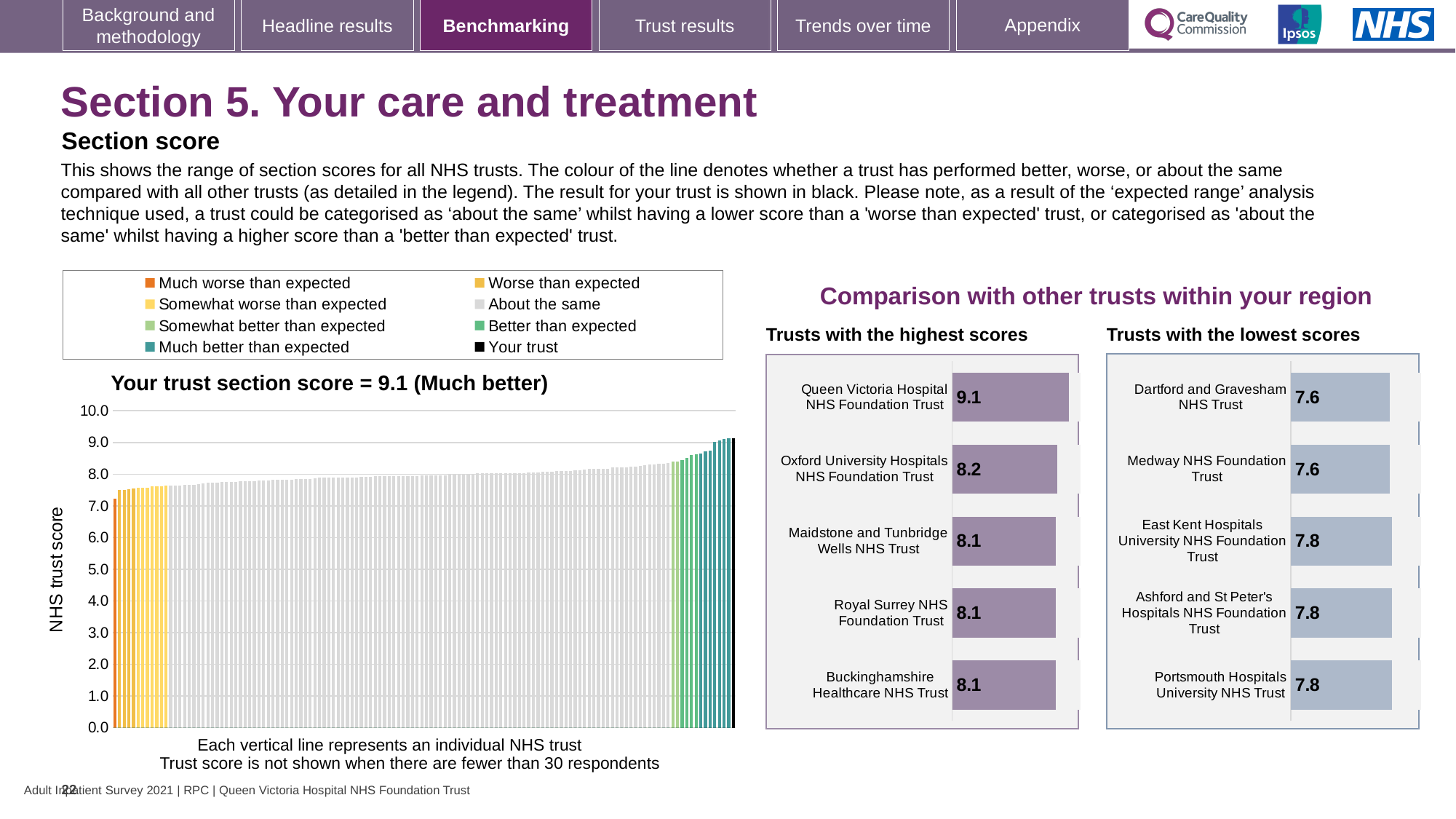
How many entries does the legend above the 'Your trust section score' chart list? 8 In the 'Trusts with the highest scores' chart, what is the difference between the scores of Queen Victoria Hospital NHS Foundation Trust and Oxford University Hospitals NHS Foundation Trust? 0.9 In the 'Trusts with the highest scores' chart, what is the score for Queen Victoria Hospital NHS Foundation Trust? 9.1 In the 'Your trust section score' chart, do the bar heights rise or fall from left to right? Rise In the 'Trusts with the highest scores' chart, what is the score for Oxford University Hospitals NHS Foundation Trust? 8.2 In the 'Trusts with the highest scores' chart, which trust has the highest score? Queen Victoria Hospital NHS Foundation Trust In the 'Your trust section score' chart, is the value of the leftmost bar greater or less than 8.0? less What type of chart is the 'Your trust section score' chart on the left? Bar chart In the 'Trusts with the lowest scores' chart, what is the difference between the scores of East Kent Hospitals University NHS Foundation Trust and Dartford and Gravesham NHS Trust? 0.2 In the 'Trusts with the lowest scores' chart, what is the score for Portsmouth Hospitals University NHS Trust? 7.8 Which is larger: the score for Medway NHS Foundation Trust in the 'Trusts with the lowest scores' chart or the score for Maidstone and Tunbridge Wells NHS Trust in the 'Trusts with the highest scores' chart? Maidstone and Tunbridge Wells NHS Trust How many trusts are listed in the 'Trusts with the lowest scores' chart? 5